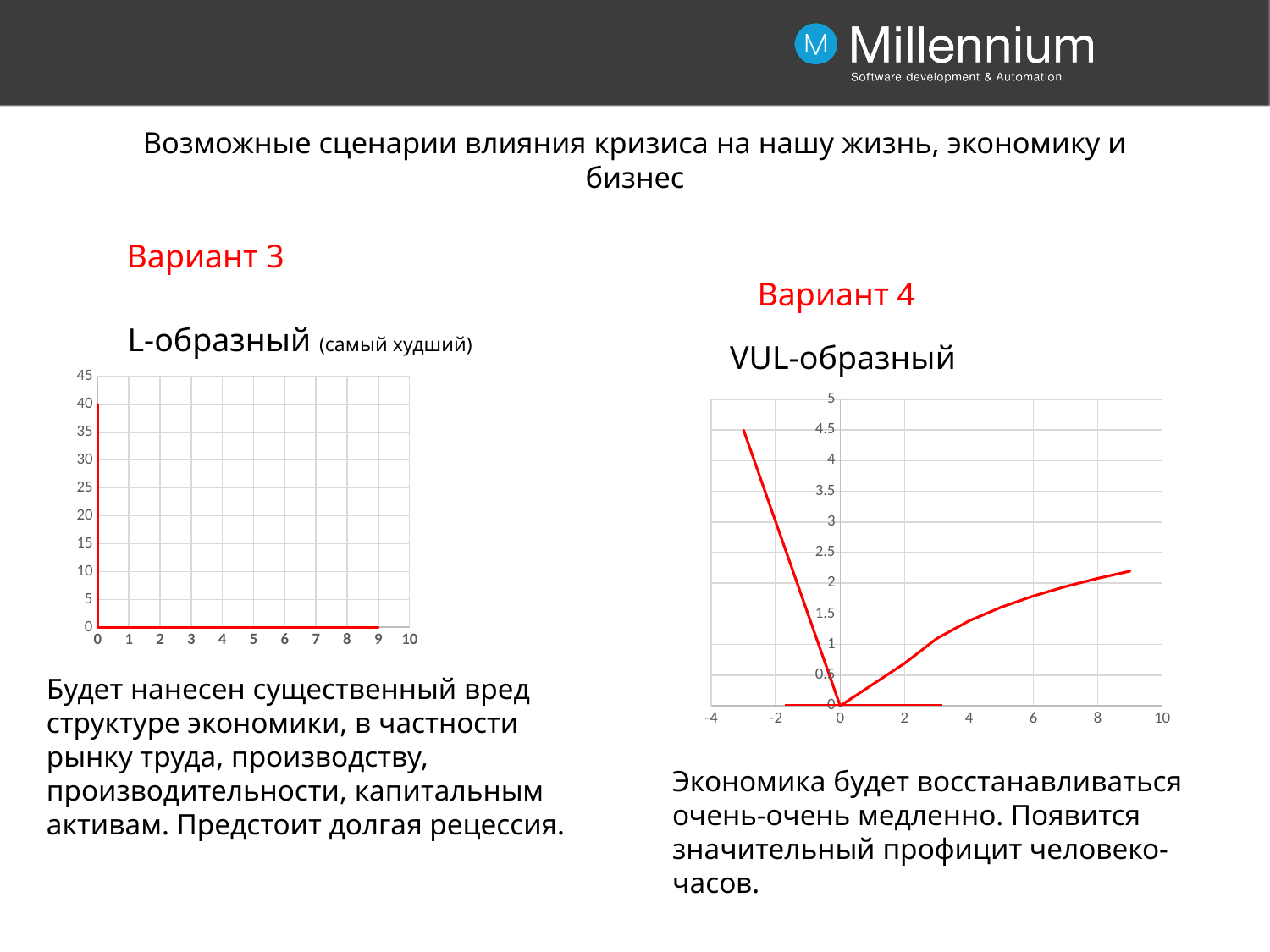
In the VUL-образный chart, is the value of the line at x = -3 greater or less than 4? greater In the VUL-образный chart, is the value of the line at x = 8 greater or less than 1.5? greater In the L-образный chart, is the value of the line at x = 5 greater or less than 20? less In the VUL-образный chart, is the value of the line at x = -3 larger or smaller than the value at x = 9? larger How many charts are shown on the slide? 2 In the VUL-образный chart, what is the highest value shown on the vertical axis? 5 In the VUL-образный chart, does the line rise or fall between x = 0 and x = 9? rises In the VUL-образный chart, does the line rise or fall between x = -3 and x = 0? falls What kind of chart is the VUL-образный chart on the right? line chart In the L-образный chart, what is the highest value shown on the vertical axis? 45 What kind of chart is the L-образный chart on the left? line chart